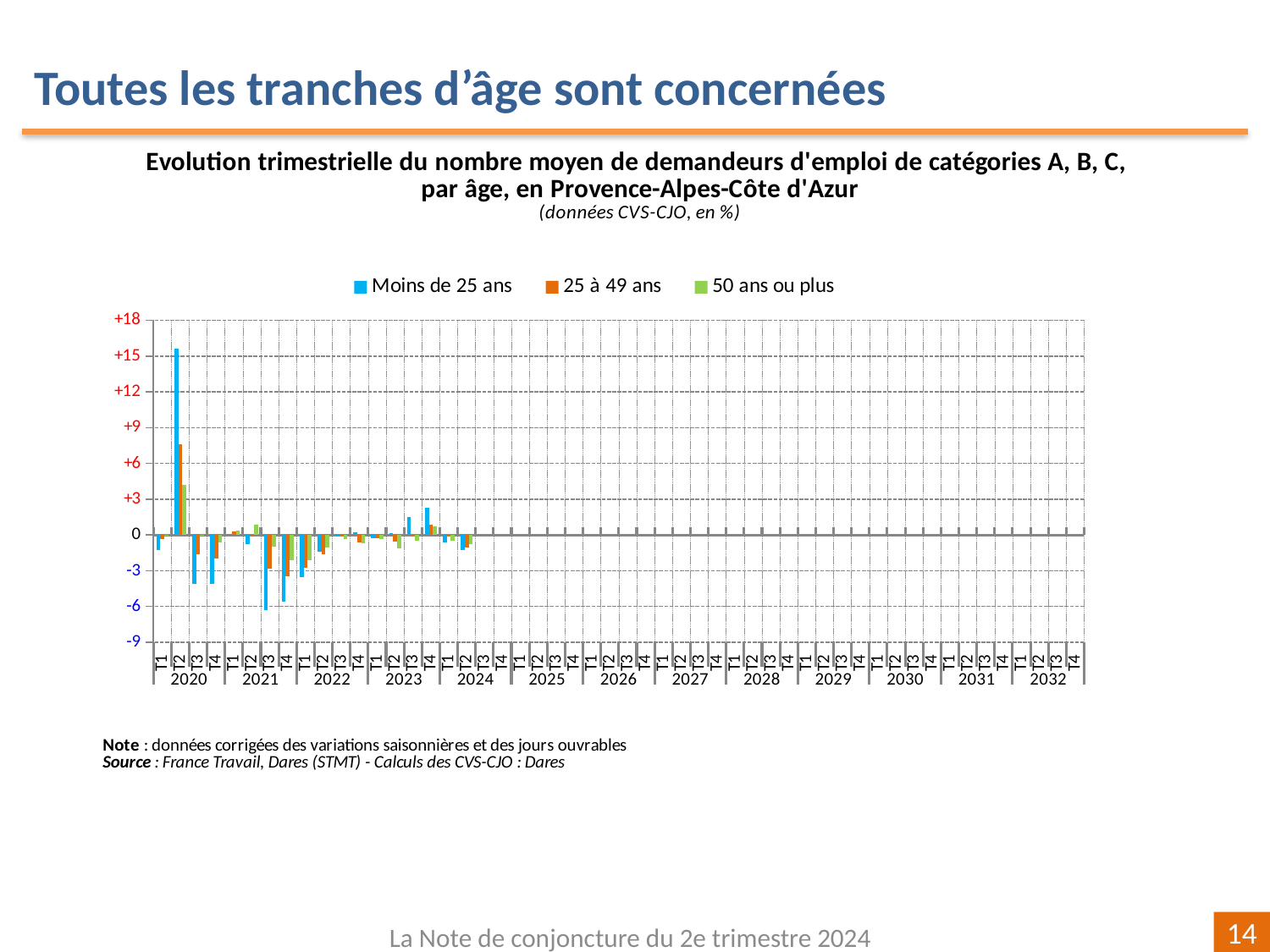
How many years are labelled along the x axis? 13 In T2 2020, which series has the larger value: 'Moins de 25 ans' or '25 à 49 ans'? Moins de 25 ans In T3 2021, which series has the lowest value? Moins de 25 ans Is the value for '25 à 49 ans' in T2 2020 greater or less than +6? greater Is the value for '50 ans ou plus' in T2 2020 greater or less than +3? greater What are the three series listed in the legend? Moins de 25 ans, 25 à 49 ans, 50 ans ou plus What kind of chart is shown on the slide? bar chart Is the value for 'Moins de 25 ans' in T3 2021 greater or less than -3? less Which colour represents the series 'Moins de 25 ans'? blue In which quarter does the 'Moins de 25 ans' series reach its highest value? T2 2020 How many series does the legend list? 3